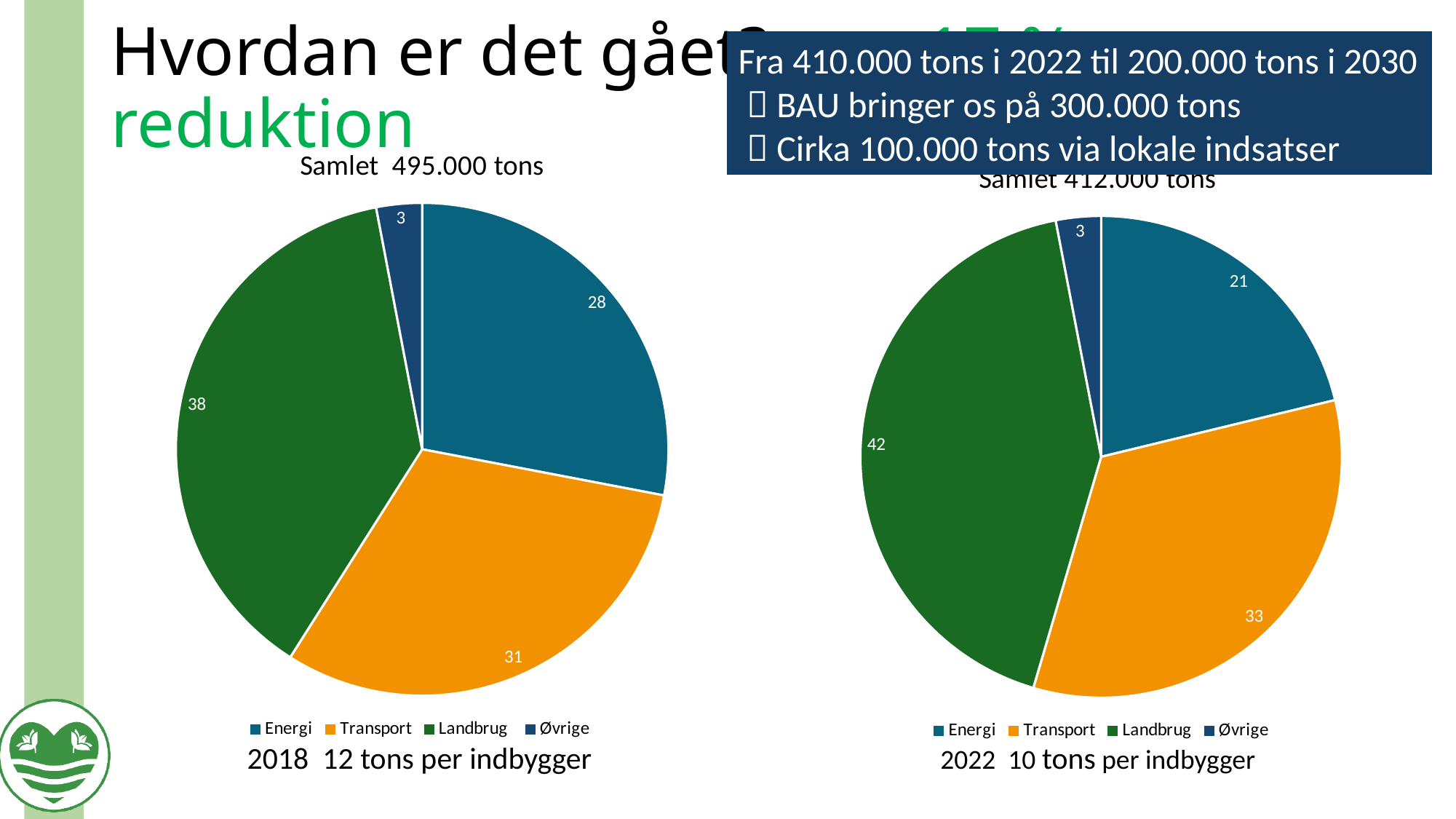
In the right pie chart (Samlet 412.000 tons), what is the value for Energi? 21 In the right pie chart (Samlet 412.000 tons), what is the value for Transport? 33 In the left pie chart (Samlet 495.000 tons), what is the difference between the Transport value and the Energi value? 3 Which colour represents Transport in the legend of the left pie chart? Orange What is the title shown above the right pie chart? Samlet 412.000 tons In the left pie chart (Samlet 495.000 tons), what is the value for Landbrug? 38 In the right pie chart (Samlet 412.000 tons), what is the difference between the Landbrug value and the Transport value? 9 How many slices does the right pie chart (Samlet 412.000 tons) have? 4 In the left pie chart (Samlet 495.000 tons), which category has the largest slice? Landbrug In the right pie chart (Samlet 412.000 tons), which category has the smallest slice? Øvrige What type of chart is used on the left side of the slide? Pie chart In the left pie chart (Samlet 495.000 tons), which is larger, Energi or Transport? Transport